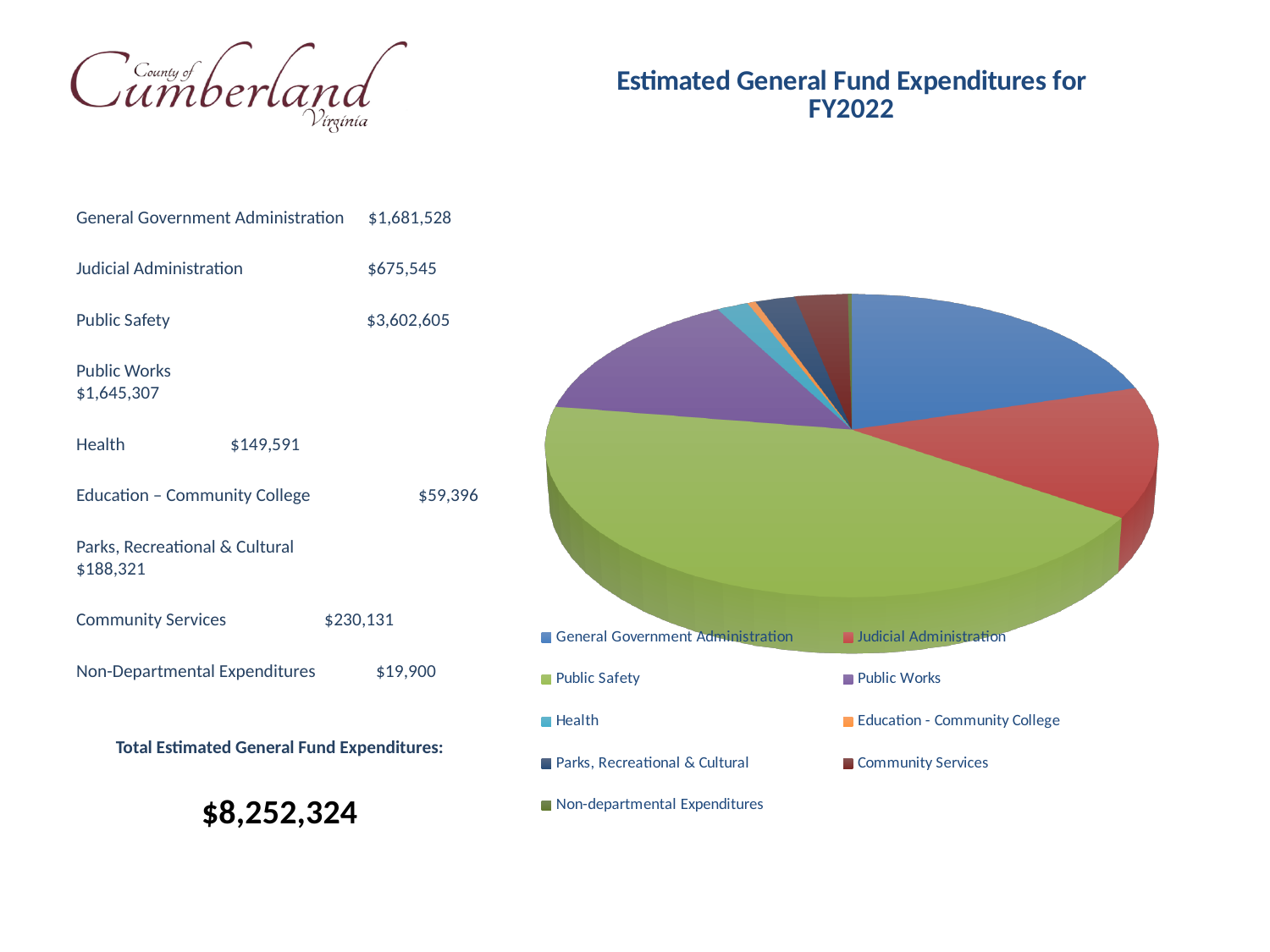
What is the difference between the Public Safety and General Government Administration expenditures? $1,921,077 What is the estimated expenditure for Public Safety? $3,602,605 What is the estimated expenditure for Health? $149,591 What is the total estimated General Fund expenditure? $8,252,324 How many categories does the pie chart have? 9 Which is larger, the expenditure for Judicial Administration or for Public Works? Public Works What is the estimated expenditure for Judicial Administration? $675,545 What kind of chart is shown on the slide? pie chart Which category has the largest slice of the pie? Public Safety What colour is the Public Safety slice in the pie chart? green Which category has the smallest slice of the pie? Non-Departmental Expenditures What is the title of the chart? Estimated General Fund Expenditures for FY2022